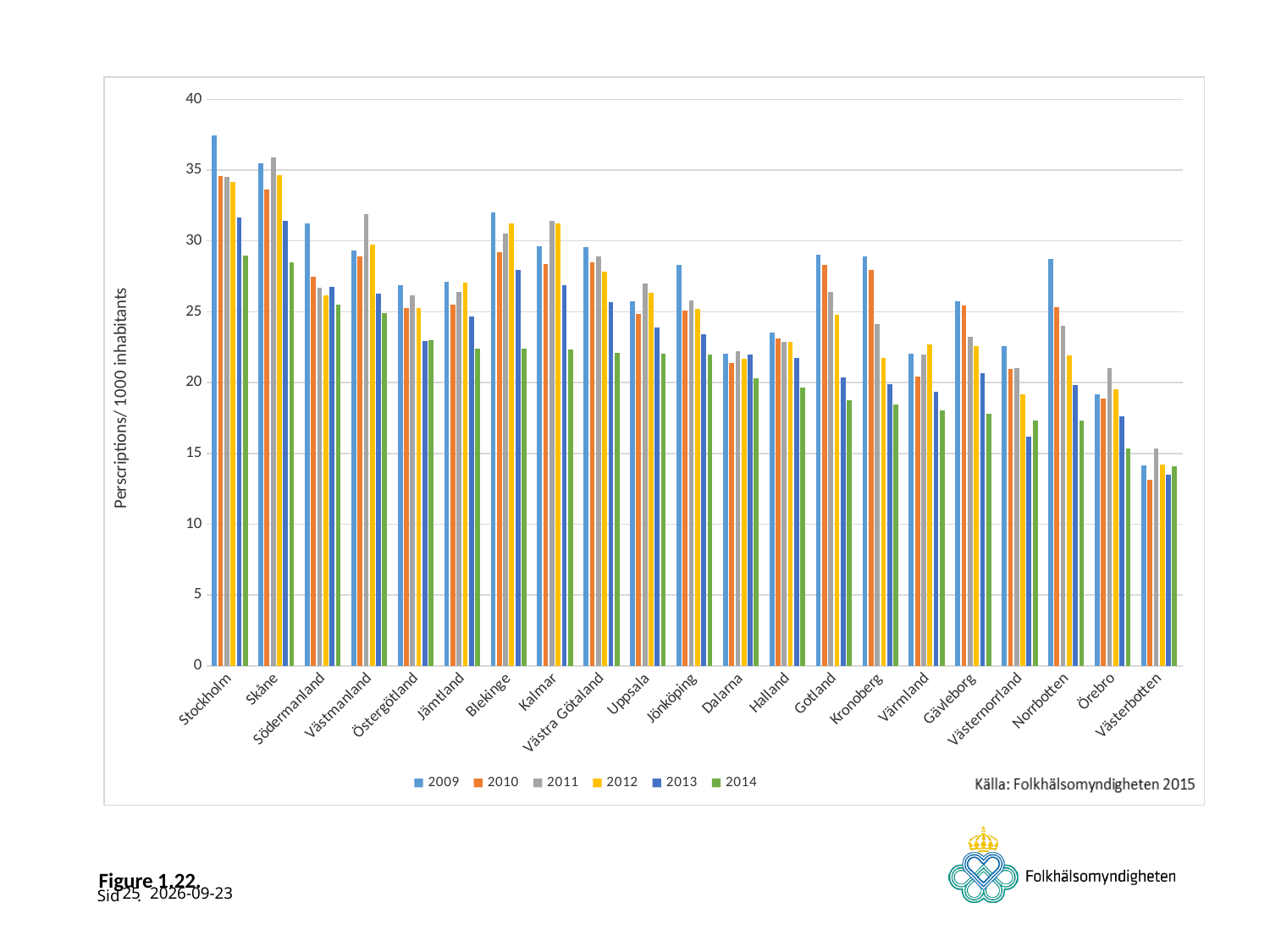
Do the 2009 values generally rise or fall moving from left to right along the x axis? fall Which region has the highest 2009 value? Stockholm Is the 2009 value for Stockholm greater or less than 35? greater Is the 2009 value for Blekinge greater or less than 30? greater What is the label on the y axis? Perscriptions/ 1000 inhabitants How many regions (categories) are shown on the x axis? 21 Which is larger, the 2014 value for Stockholm or the 2014 value for Västerbotten? Stockholm What kind of chart is shown on the slide? bar chart Which region has the lowest 2009 value? Västerbotten Is the 2009 value for Västerbotten greater or less than 15? less How many series does the legend list? 6